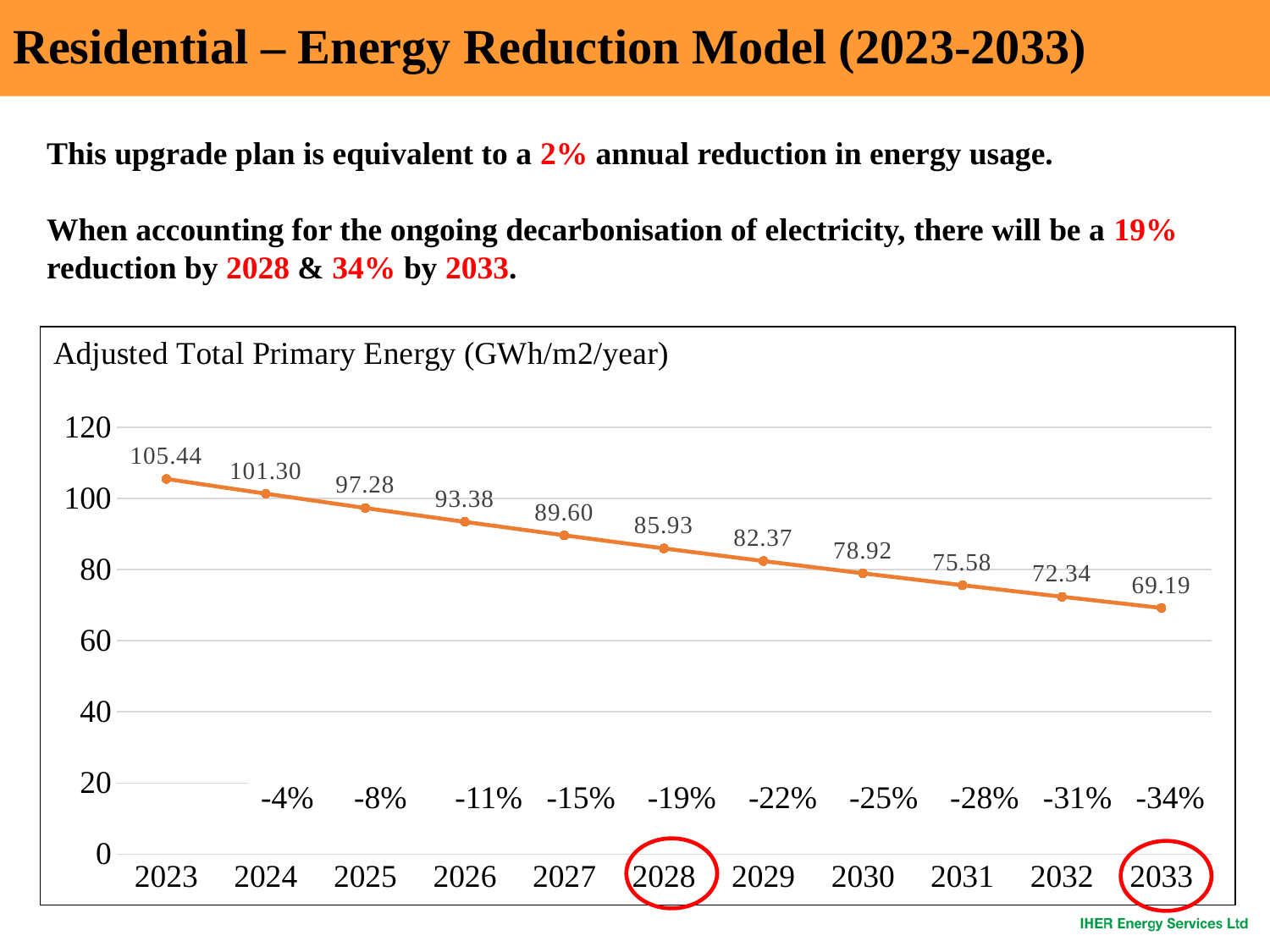
Which year has the highest Adjusted Total Primary Energy value? 2023 What is the Adjusted Total Primary Energy value for 2023? 105.44 What is the Adjusted Total Primary Energy value for 2030? 78.92 What is the Adjusted Total Primary Energy value for 2033? 69.19 What kind of chart is shown on the slide? line chart Is the value for 2027 greater or less than 80? greater What is the difference between the 2023 value and the 2033 value? 36.25 How many years are plotted on the chart? 11 Do the values rise or fall from 2023 to 2033? fall Which is larger, the value for 2025 or the value for 2029? 2025 Which year has the lowest Adjusted Total Primary Energy value? 2033 What is the Adjusted Total Primary Energy value for 2028? 85.93